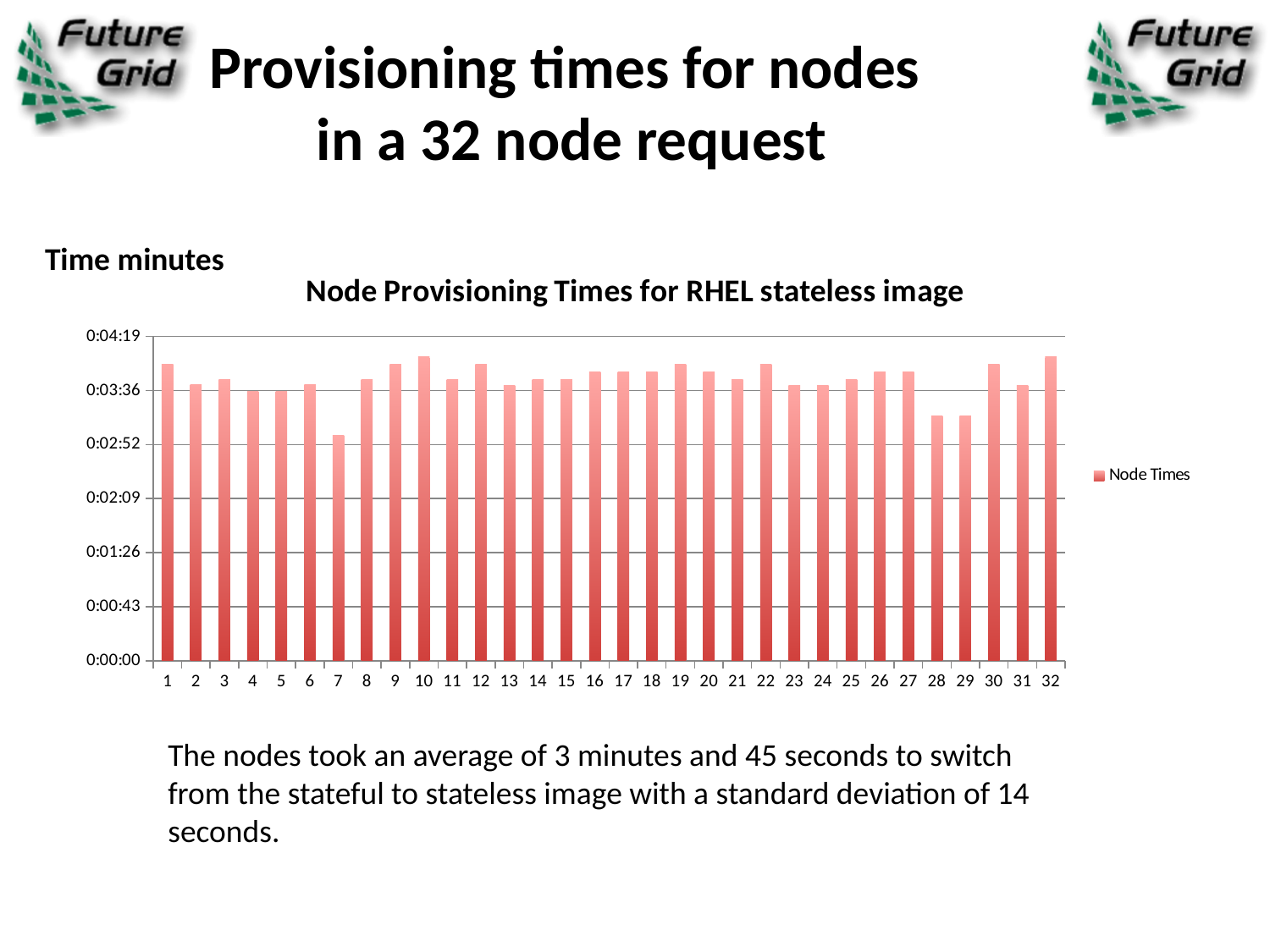
How many series does the legend list? 1 Is the value for node 7 greater or less than 0:02:52? greater How many nodes (categories) are plotted along the x axis? 32 Which node has the lowest provisioning time? 7 What is the name of the series shown in the legend? Node Times Which has the larger provisioning time, node 1 or node 7? Node 1 What kind of chart is shown on the slide? Bar chart Is the value for node 28 greater or less than 0:03:36? less Is the value for node 1 greater or less than 0:03:36? greater Which has the larger provisioning time, node 10 or node 29? Node 10 What is the title of the chart? Node Provisioning Times for RHEL stateless image